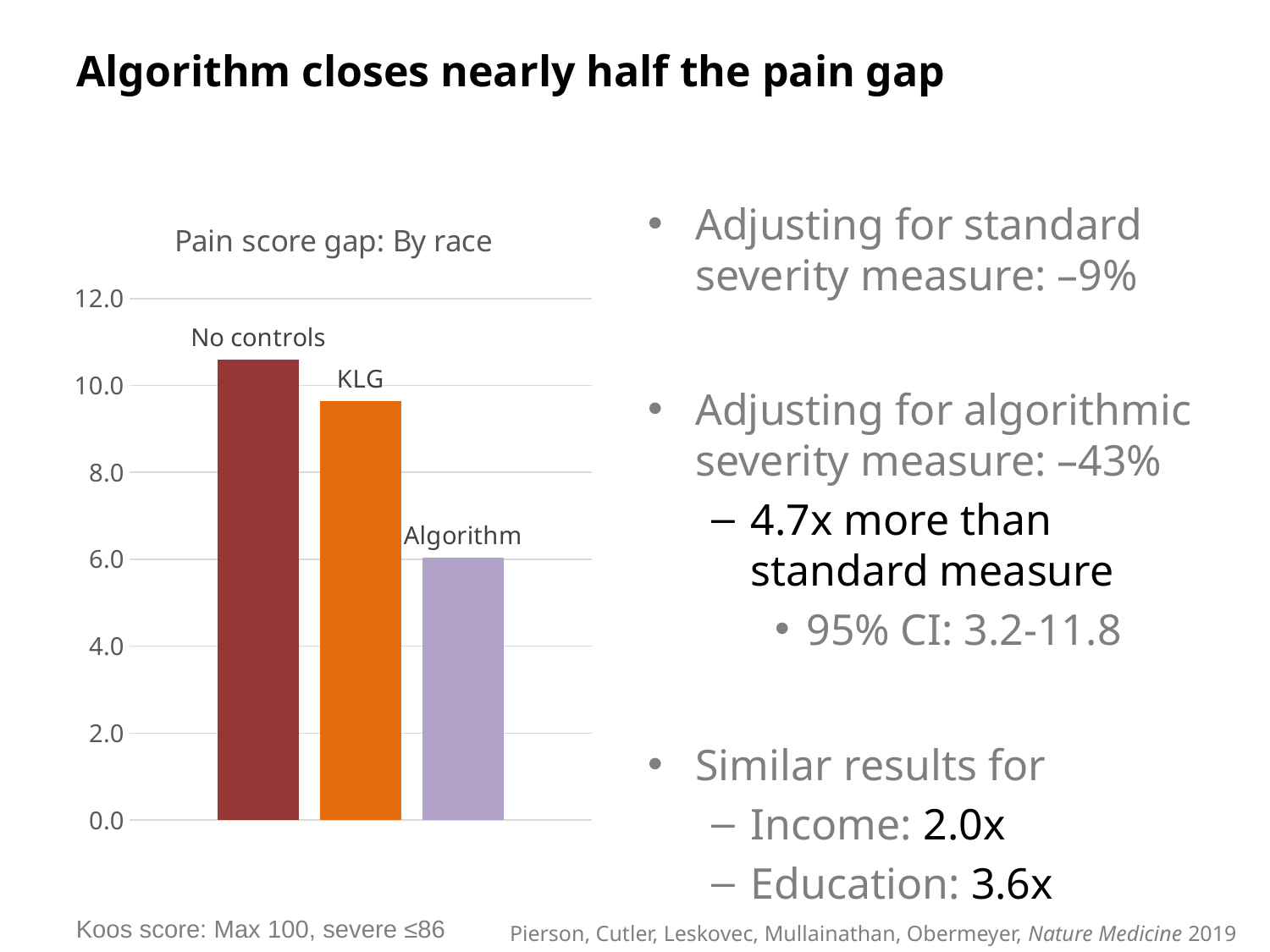
Is the value for No controls greater or less than 10.0? greater Which category has the lowest pain score gap? Algorithm What kind of chart is shown on the slide? bar chart How many bars (categories) does the chart show? 3 Do the bar values rise or fall from left to right across the chart? fall What colour is the Algorithm bar? light purple Is the value for KLG greater or less than 10.0? less Which is larger, the value for No controls or the value for KLG? No controls Is the value for Algorithm greater or less than 8.0? less Which category has the highest pain score gap? No controls What is the title of the chart? Pain score gap: By race Which is larger, the value for KLG or the value for Algorithm? KLG